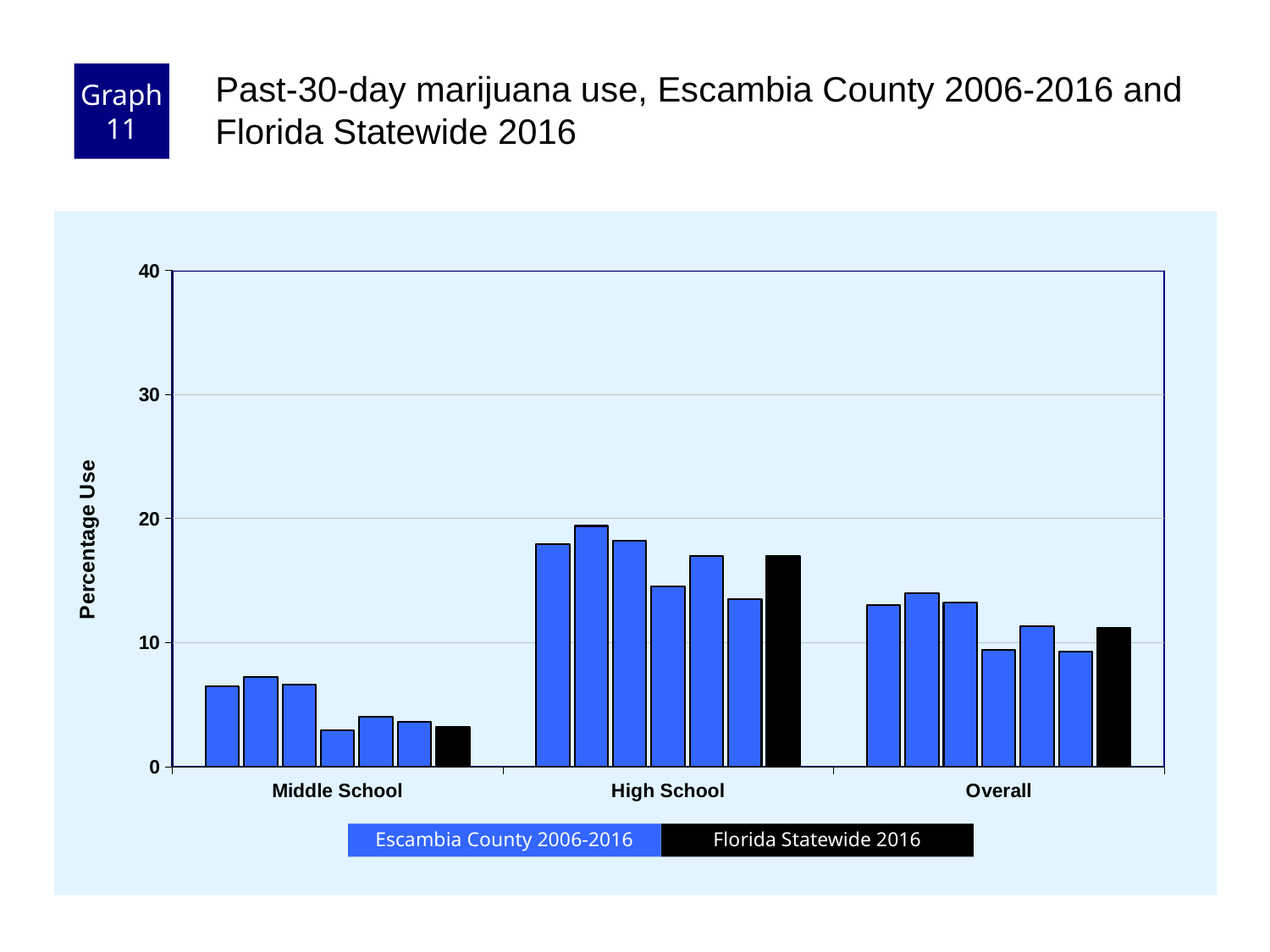
Is the Florida Statewide 2016 value for High School greater or less than 20? less What kind of chart is shown on the slide? bar chart Is the Florida Statewide 2016 value for High School greater or less than 10? greater What is the label on the y axis? Percentage Use Which is larger, the Florida Statewide 2016 value for High School or for Overall? High School Is the Florida Statewide 2016 value for Middle School greater or less than 10? less What are the two series named in the legend? Escambia County 2006-2016 and Florida Statewide 2016 How many series does the legend list? 2 Which category has the highest Florida Statewide 2016 value? High School Which category has the lowest Florida Statewide 2016 value? Middle School How many categories are shown on the x axis? 3